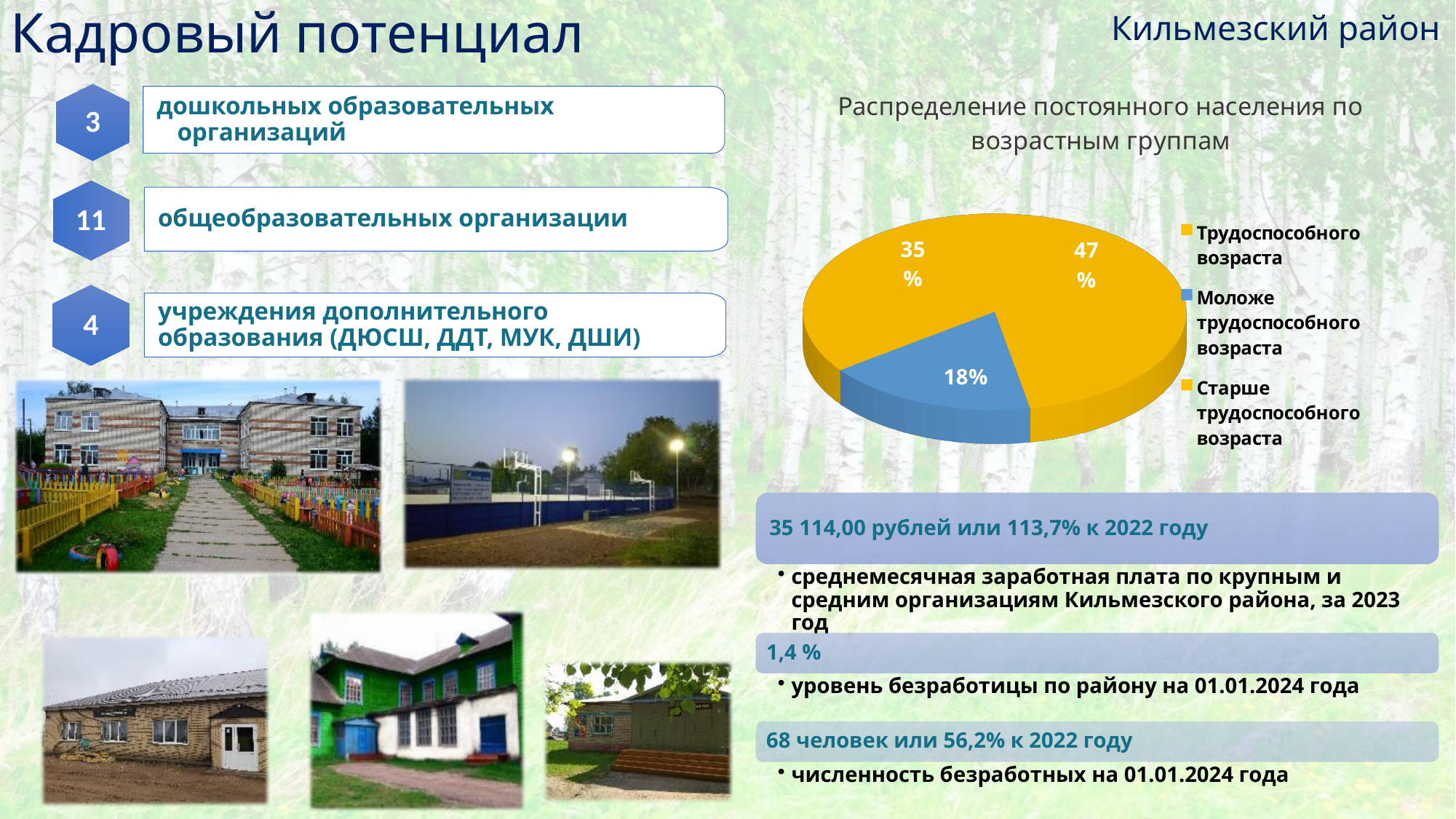
Which colour represents the group younger than working age in the pie chart? blue How many slices does the pie chart have? 3 What share of the population is older than working age (Старше трудоспособного возраста)? 35% By how many percentage points does the working-age share exceed the share older than working age? 12 What kind of chart is shown on the slide? pie chart Which is larger: the share older than working age or the share younger than working age? Старше трудоспособного возраста How many entries does the legend of the pie chart list? 3 Which age group has the largest share in the pie chart? Трудоспособного возраста Which age group has the smallest share in the pie chart? Моложе трудоспособного возраста What share of the population is younger than working age (Моложе трудоспособного возраста)? 18% What share of the population is of working age (Трудоспособного возраста) according to the pie chart? 47% What is the title of the pie chart? Распределение постоянного населения по возрастным группам